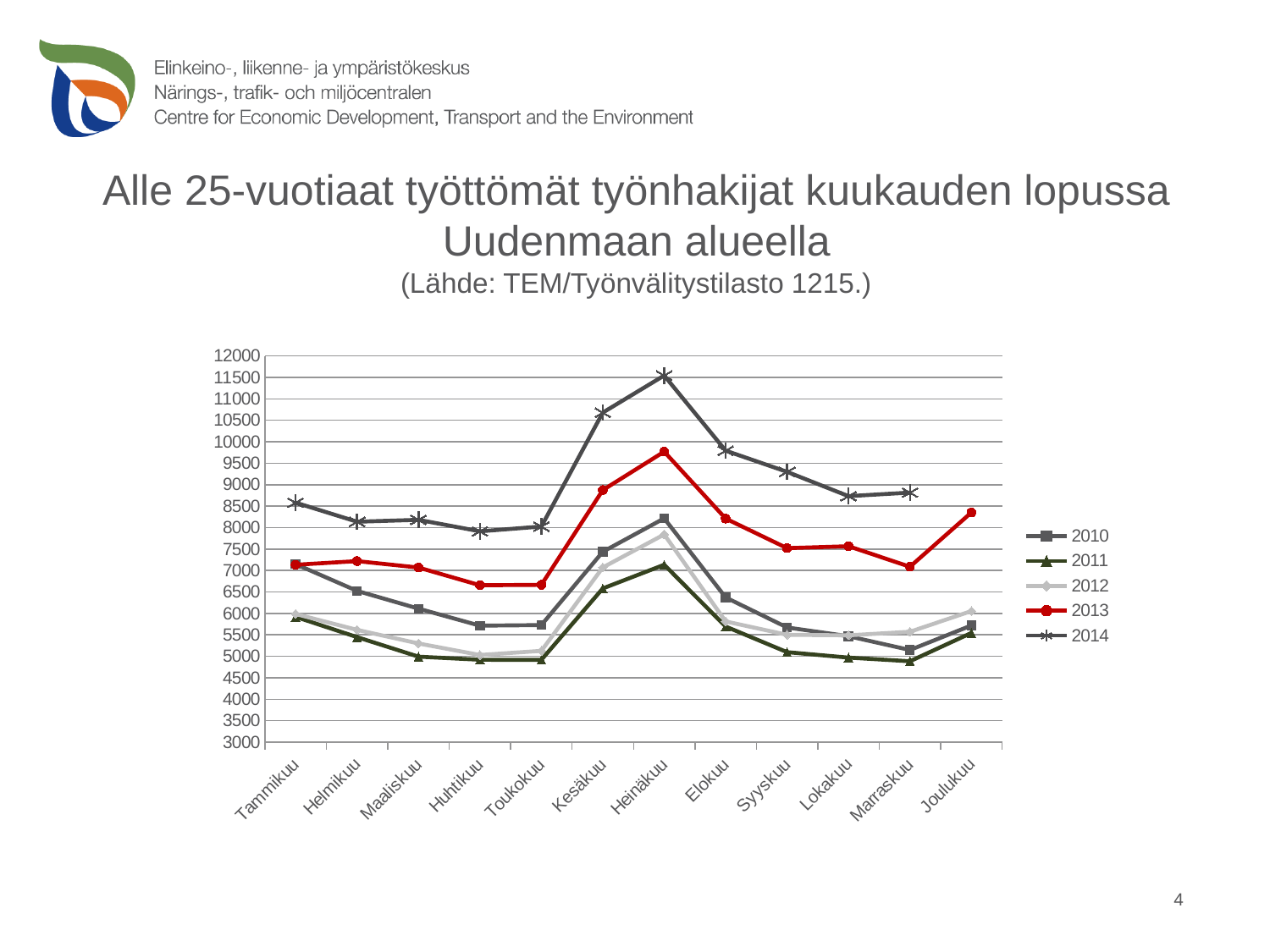
Is the value for 2011 in Huhtikuu greater or less than 5500? less In Tammikuu, which series has the larger value, 2014 or 2013? 2014 How many months are shown along the x axis? 12 How many series does the legend list? 5 In which month does the 2014 series reach its highest value? Heinäkuu Is the value for 2010 in Helmikuu greater or less than 7000? less Which years are listed in the chart legend? 2010, 2011, 2012, 2013, 2014 Does the 2014 series rise or fall from Heinäkuu to Lokakuu? fall In Heinäkuu, which series has the larger value, 2013 or 2010? 2013 What kind of chart is shown on the slide? Line chart Is the value for 2014 in Heinäkuu greater or less than 11000? greater In which month does the 2013 series reach its highest value? Heinäkuu